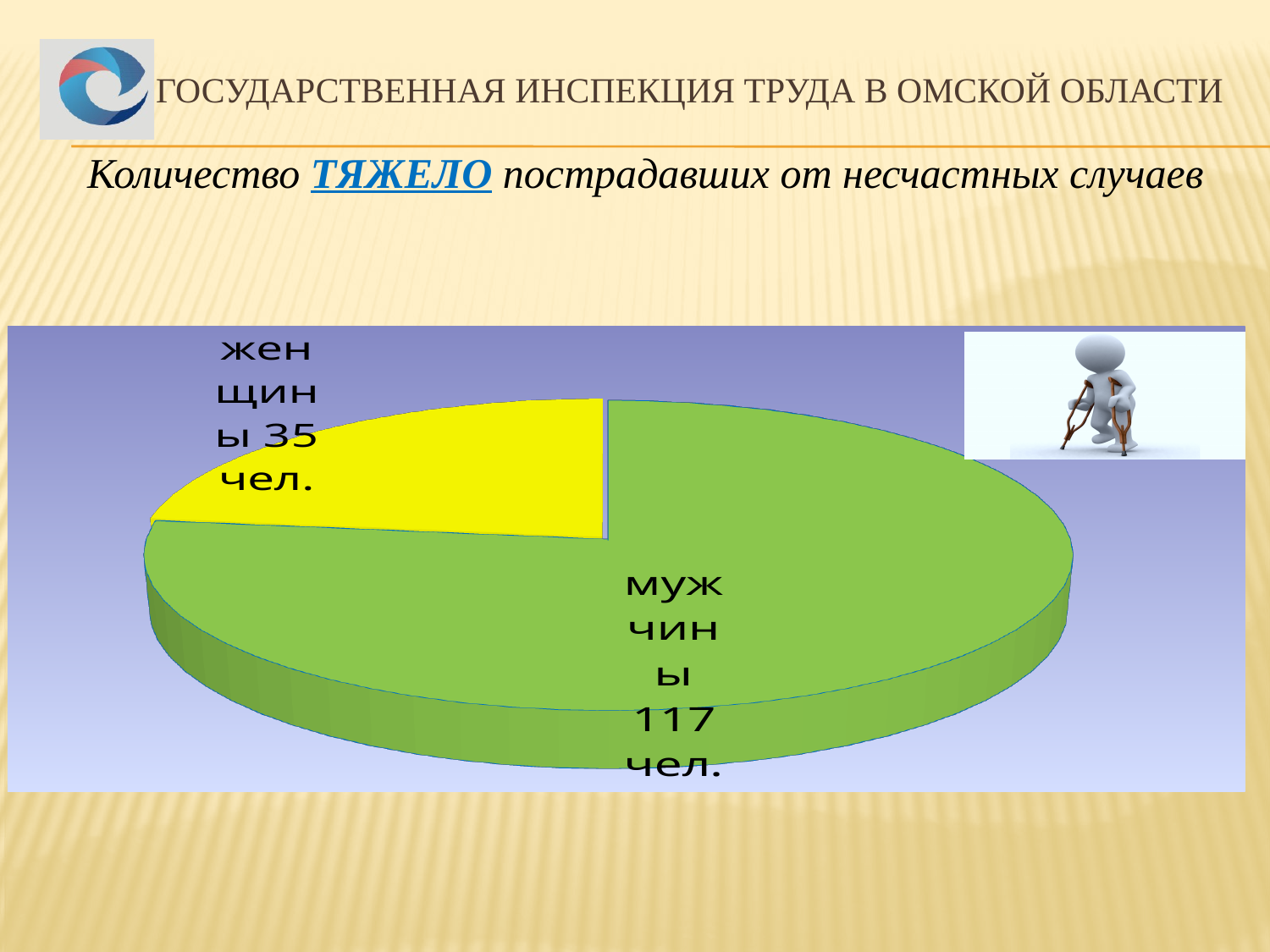
What is the value shown for женщины? 35 чел. What is the value shown for мужчины? 117 чел. What is the total number of people represented in the pie chart? 152 чел. Which is larger, the value for мужчины or the value for женщины? мужчины What colour is the slice for мужчины? green How many slices does the pie chart have? 2 What is the difference between the number of мужчины and the number of женщины? 82 чел. What share of the pie does the женщины slice represent, to the nearest whole percent? 23% What kind of chart is shown on the slide? pie chart Which category has the smallest slice of the pie? женщины What colour is the slice for женщины? yellow Which category has the largest slice of the pie? мужчины